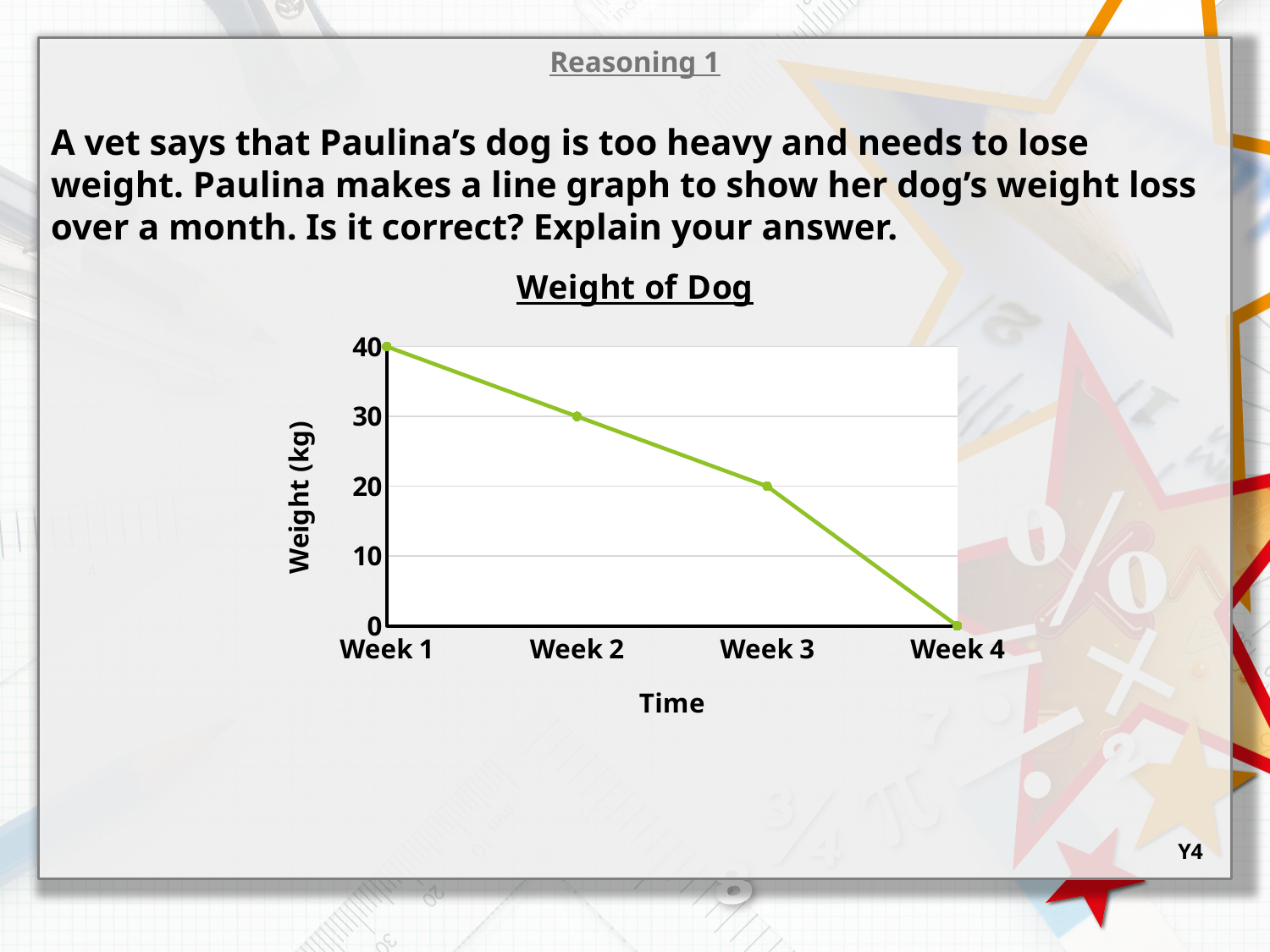
What kind of chart is shown on the slide? Line chart Do the values rise or fall from Week 1 to Week 4? Fall In which week is the dog's weight highest? Week 1 What is the difference in weight between Week 1 and Week 3? 20 What is the dog's weight in Week 1? 40 What is the dog's weight in Week 3? 20 What is the dog's weight in Week 2? 30 Which is larger, the weight in Week 2 or the weight in Week 3? Week 2 How many weeks are plotted on the x axis? 4 What is the dog's weight in Week 4? 0 What is the title of the chart? Weight of Dog In which week is the dog's weight lowest? Week 4